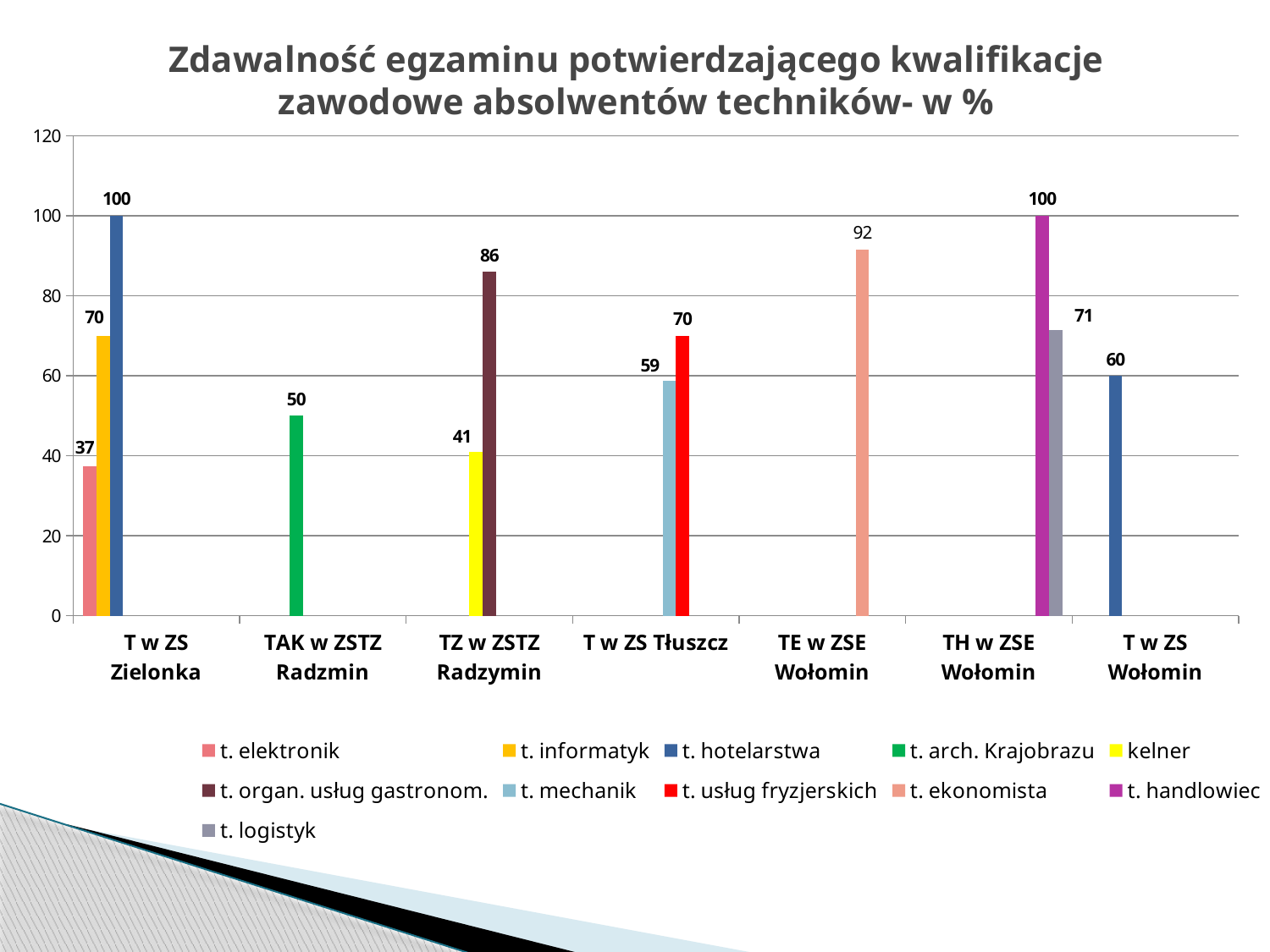
What colour is the bar for t. usług fryzjerskich? red Which is larger: the kelner value at TZ w ZSTZ Radzymin or the t. arch. Krajobrazu value at TAK w ZSTZ Radzmin? t. arch. Krajobrazu at TAK w ZSTZ Radzmin What is the pass rate for t. elektronik at T w ZS Zielonka? 37 Which series has the lowest value at T w ZS Zielonka? t. elektronik What is the difference between the t. usług fryzjerskich and t. mechanik values at T w ZS Tłuszcz? 11 What is the pass rate for t. organ. usług gastronom. at TZ w ZSTZ Radzymin? 86 What is the difference between the t. handlowiec and t. logistyk values at TH w ZSE Wołomin? 29 What kind of chart is shown on the slide? bar chart How many series does the legend list? 11 What is the pass rate for t. ekonomista at TE w ZSE Wołomin? 92 What is the pass rate for t. hotelarstwa at T w ZS Wołomin? 60 How many school categories are shown on the x axis? 7